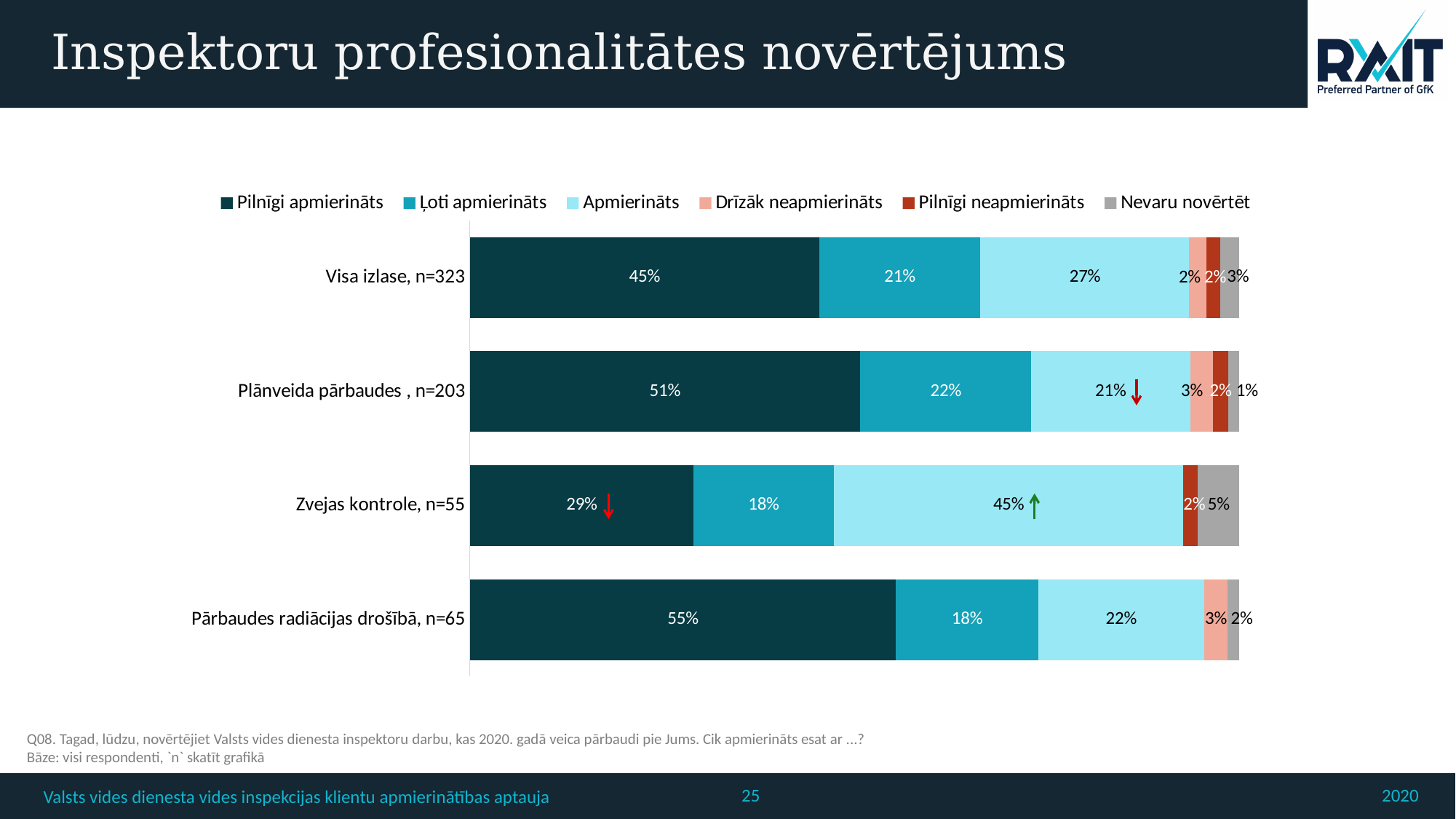
What is the difference between the 'Pilnīgi apmierināts' share for 'Pārbaudes radiācijas drošībā, n=65' and for 'Zvejas kontrole, n=55'? 26% What type of chart is shown on the slide? Stacked bar chart What is the 'Ļoti apmierināts' value for 'Plānveida pārbaudes , n=203'? 22% How many groups (bars) are shown in the chart? 4 Which group has the highest 'Pilnīgi apmierināts' share? Pārbaudes radiācijas drošībā, n=65 Which is larger: the 'Apmierināts' share for 'Visa izlase, n=323' or for 'Plānveida pārbaudes , n=203'? Visa izlase, n=323 What is the title of the slide? Inspektoru profesionalitātes novērtējums How many series does the legend list? 6 What percentage of respondents in the 'Visa izlase, n=323' group are 'Pilnīgi apmierināts'? 45% Which group has the lowest 'Pilnīgi apmierināts' share? Zvejas kontrole, n=55 What is the 'Nevaru novērtēt' share for 'Zvejas kontrole, n=55'? 5% What is the 'Apmierināts' share for 'Zvejas kontrole, n=55'? 45%